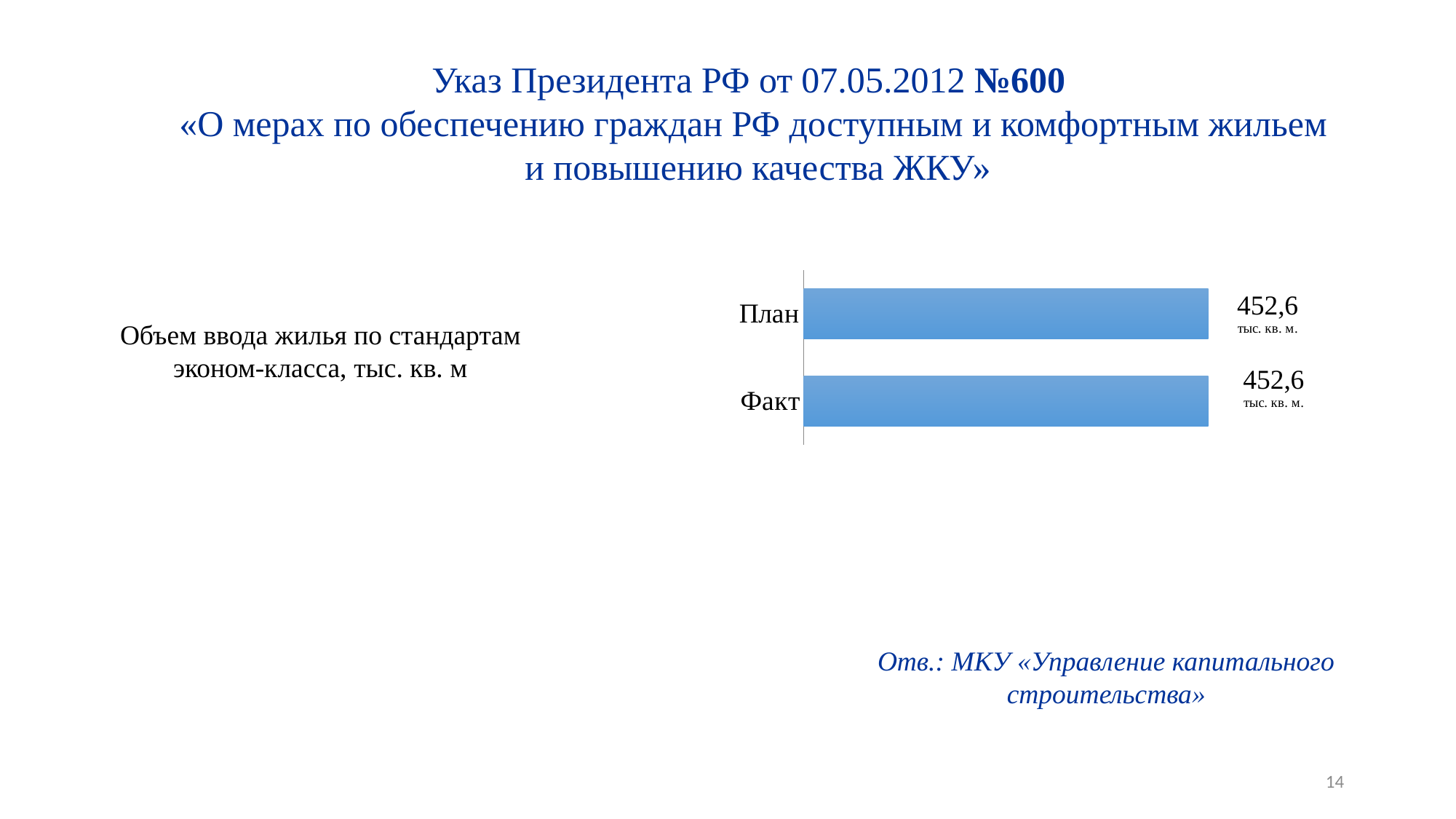
What indicator does the chart describe, according to the text to its left? Объем ввода жилья по стандартам эконом-класса, тыс. кв. м What is the difference between the План and Факт values? 0 What is the value for Факт (Fact)? 452,6 Are the План and Факт values equal or different? equal Which category is listed first (at the top) of the chart? План How many bars does the chart show? 2 What kind of chart is shown on the slide? bar chart What is the value for План (Plan)? 452,6 What unit is shown next to the data labels on the chart? тыс. кв. м.